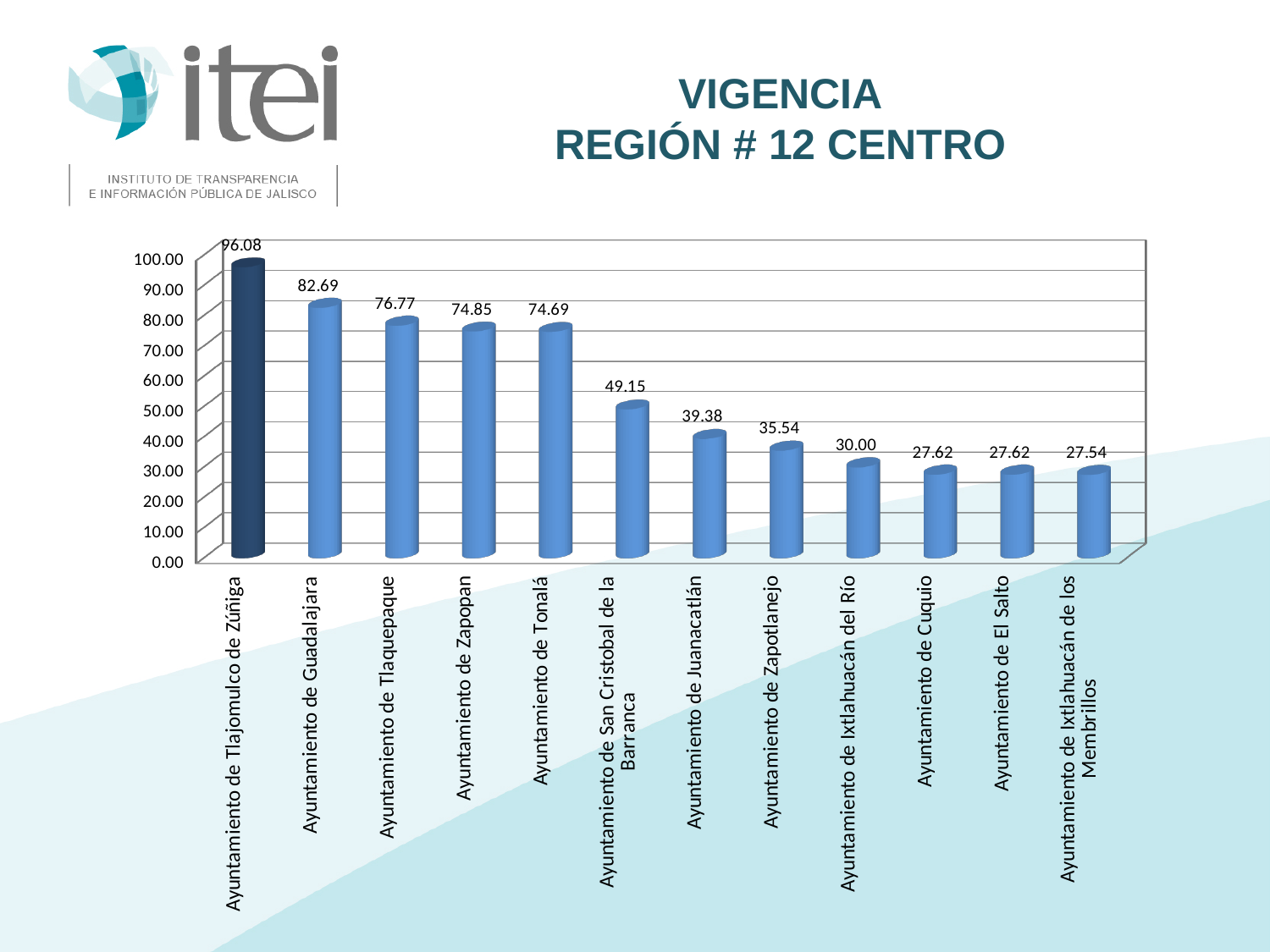
What kind of chart is shown on the slide? Bar chart What is the value for Ayuntamiento de Ixtlahuacán del Río? 30.00 What is the value for Ayuntamiento de Guadalajara? 82.69 Which is larger, the value for Ayuntamiento de Zapopan or Ayuntamiento de Zapotlanejo? Ayuntamiento de Zapopan What is the difference between the values for Ayuntamiento de San Cristobal de la Barranca and Ayuntamiento de Juanacatlán? 9.77 What is the value for Ayuntamiento de San Cristobal de la Barranca? 49.15 Do the values rise or fall from left to right along the x axis? Fall What is the difference between the values for Ayuntamiento de Tlajomulco de Zúñiga and Ayuntamiento de Guadalajara? 13.39 What is the value for Ayuntamiento de Tonalá? 74.69 How many categories are shown in the chart? 12 Which category has the highest value? Ayuntamiento de Tlajomulco de Zúñiga Which category has the lowest value? Ayuntamiento de Ixtlahuacán de los Membrillos